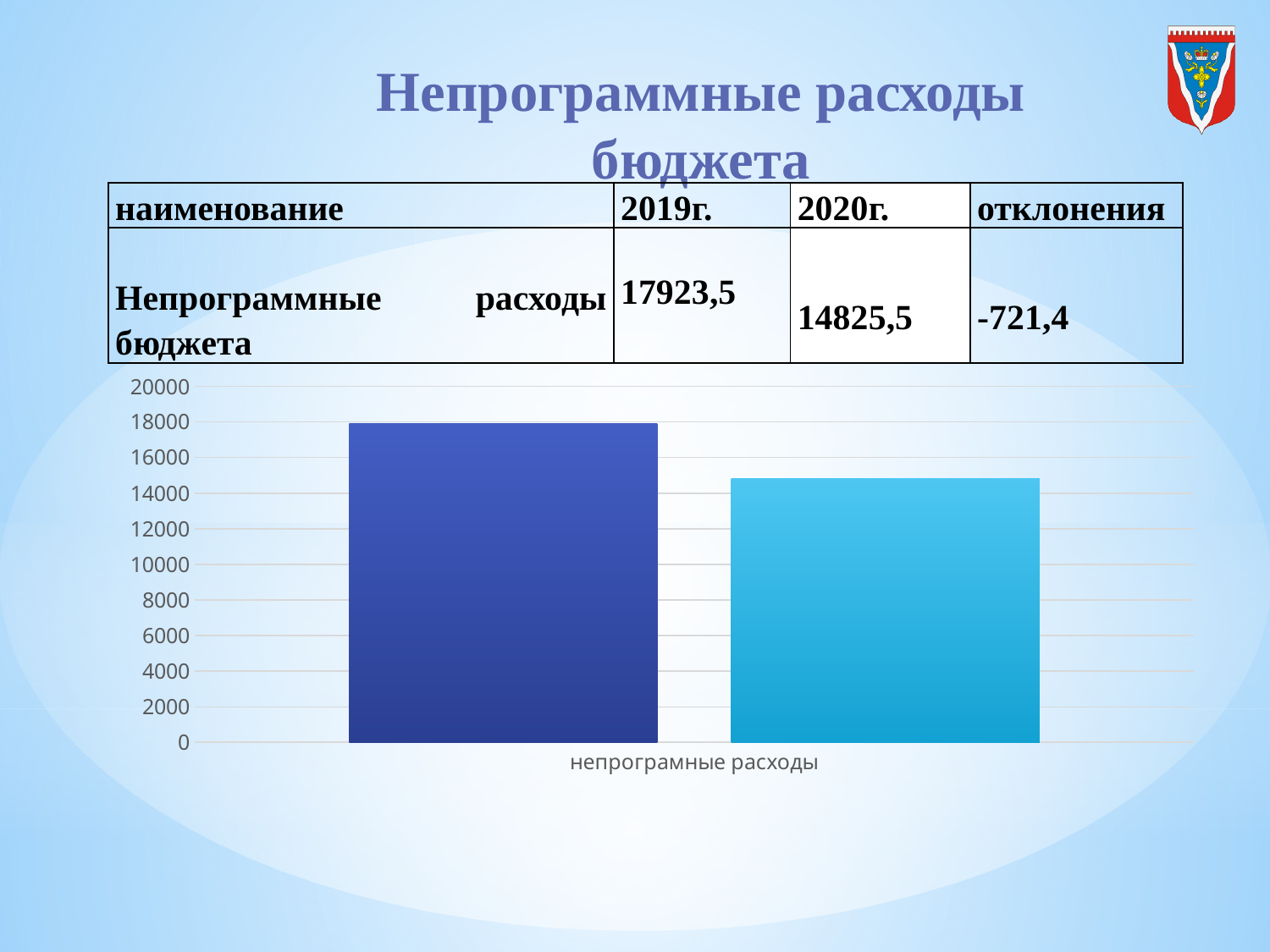
What is the highest value shown on the vertical axis of the chart? 20000 What kind of chart is shown on the slide? bar chart Is the value of the light blue bar on the right greater or less than 16000? less Do the bar values rise or fall from left to right across the chart? fall Is the value of the dark blue bar on the left greater or less than 20000? less Is the value of the light blue bar on the right greater or less than 14000? greater Which bar is the shortest in the chart? the light blue bar on the right What is the category label shown under the bars on the x axis? непрограмные расходы How many bars are plotted in the chart? 2 Which bar is taller, the dark blue bar on the left or the light blue bar on the right? the dark blue bar on the left